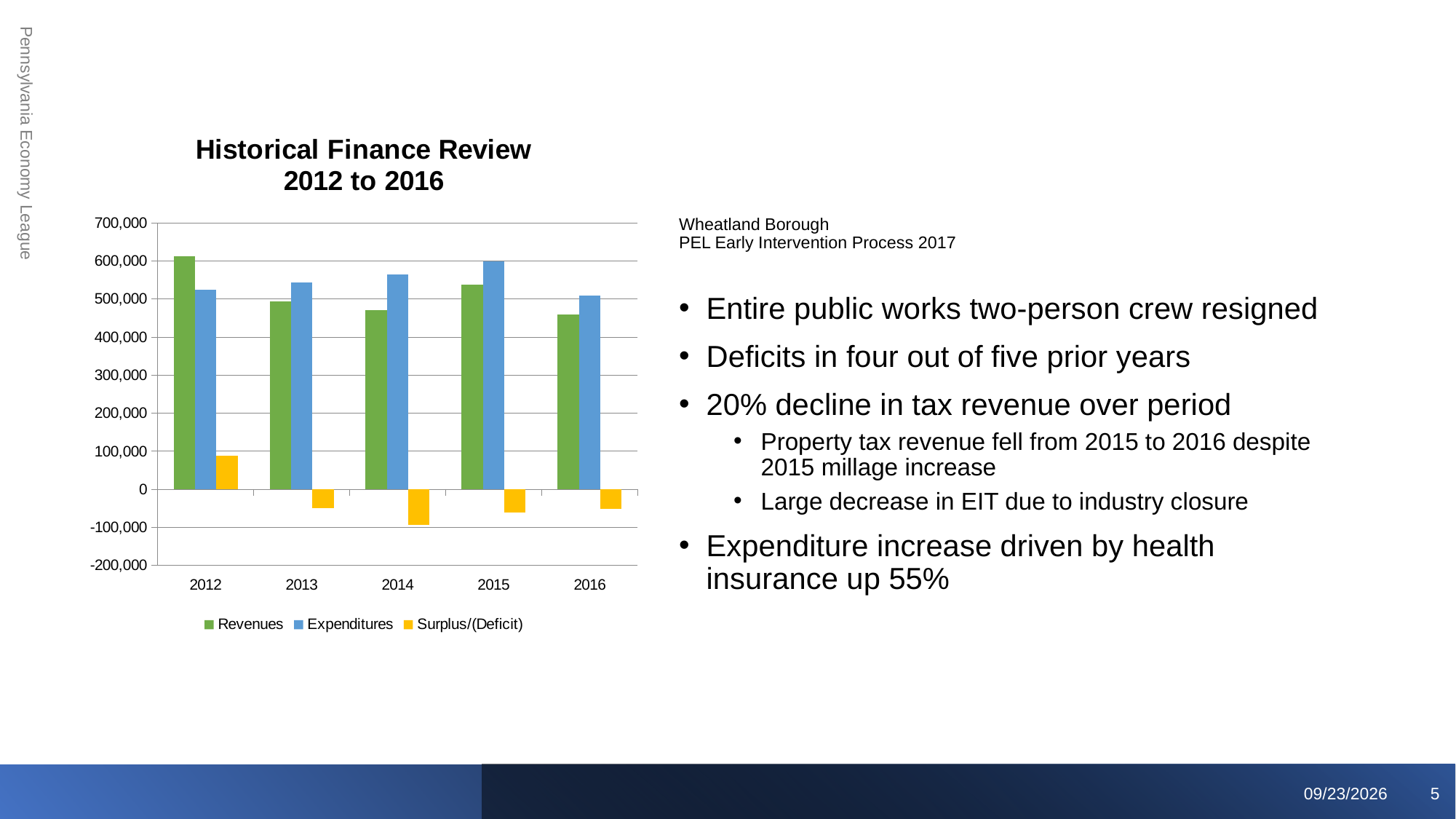
What kind of chart is shown on the slide? bar chart Is the value for Surplus/(Deficit) in 2014 greater or less than 0? less In 2012, which is larger, Revenues or Expenditures? Revenues What is the title of the chart? Historical Finance Review 2012 to 2016 In which year is the Surplus/(Deficit) highest? 2012 In which year is the Surplus/(Deficit) lowest? 2014 Is the value for Revenues in 2012 greater or less than 500,000? greater In which year are Revenues highest? 2012 In 2015, which is larger, Revenues or Expenditures? Expenditures How many years are shown on the x axis of the chart? 5 In which year are Expenditures highest? 2015 How many series does the chart legend list? 3